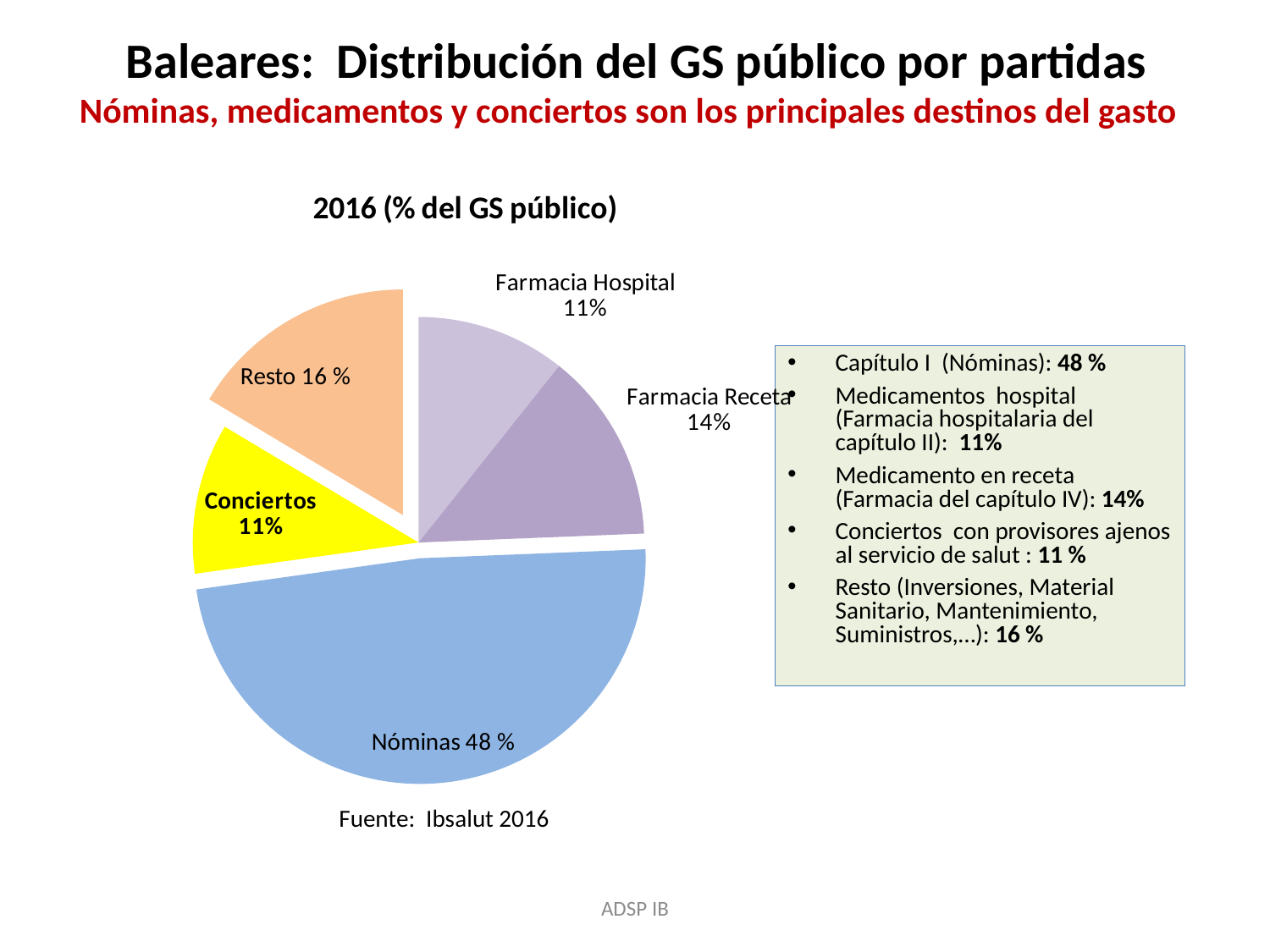
What is the value shown for Resto? 16 % What is the value shown for Farmacia Receta? 14% What source is cited below the chart? Fuente: Ibsalut 2016 What is the value shown for Farmacia Hospital? 11% What share of the pie does Nóminas represent? 48 % What is the difference between the Nóminas share and the Resto share? 32 % What kind of chart is shown on the slide? pie chart How many slices does the pie chart have? 5 Which category has the largest slice of the pie? Nóminas What is the title of the chart? 2016 (% del GS público) Which is larger, Farmacia Receta or Farmacia Hospital? Farmacia Receta What is the value shown for Conciertos? 11%